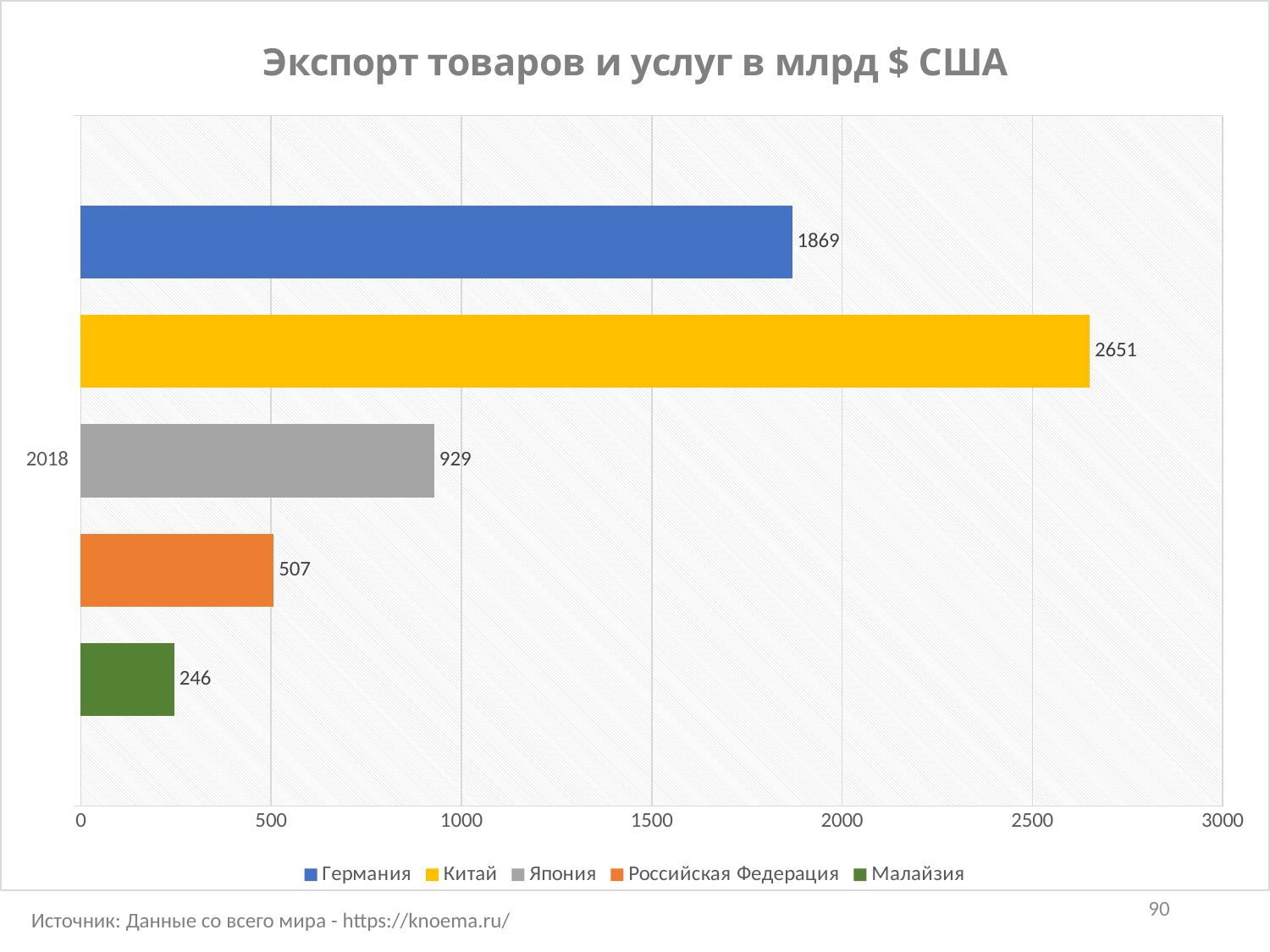
What kind of chart is shown on the slide? bar chart What is the title of the chart? Экспорт товаров и услуг в млрд $ США What is the export value for Германия? 1869 How many series does the legend list? 5 What is the difference between the export values of Япония and Российская Федерация? 422 What is the export value for Китай? 2651 Which country has the highest export value? Китай What is the difference between the export values of Китай and Германия? 782 Which is larger, the export value for Япония or for Малайзия? Япония Which country has the lowest export value? Малайзия Is the value for Германия greater or less than 2000? less What is the export value for Российская Федерация? 507